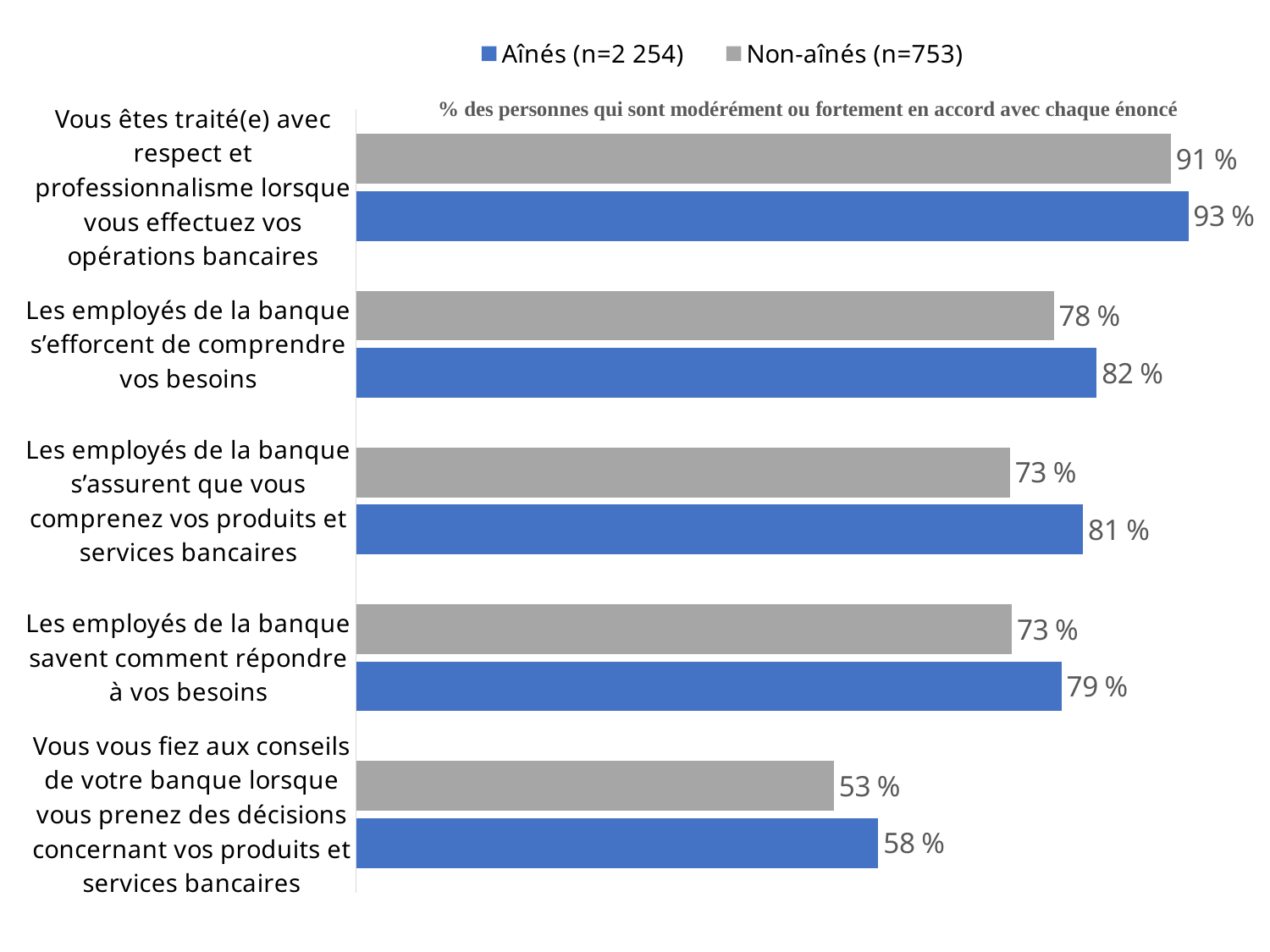
Which statement has the lowest value for Non-aînés? Vous vous fiez aux conseils de votre banque lorsque vous prenez des décisions concernant vos produits et services bancaires What is the difference between Aînés and Non-aînés for the statement 'Les employés de la banque s'assurent que vous comprenez vos produits et services bancaires'? 8 % What type of chart is shown on the slide? bar chart What colour are the bars for the Aînés series? blue What is the value for Non-aînés for the statement 'Les employés de la banque s'efforcent de comprendre vos besoins'? 78 % What is the sample size (n) for the Non-aînés series shown in the legend? 753 What is the value for Aînés for the statement 'Vous êtes traité(e) avec respect et professionnalisme lorsque vous effectuez vos opérations bancaires'? 93 % What is the value for Aînés for the statement 'Vous vous fiez aux conseils de votre banque lorsque vous prenez des décisions concernant vos produits et services bancaires'? 58 % For the statement 'Les employés de la banque savent comment répondre à vos besoins', which group has the larger value, Aînés or Non-aînés? Aînés How many series does the legend list? 2 How many statements (categories) are shown in the chart? 5 Which statement has the highest value for Aînés? Vous êtes traité(e) avec respect et professionnalisme lorsque vous effectuez vos opérations bancaires